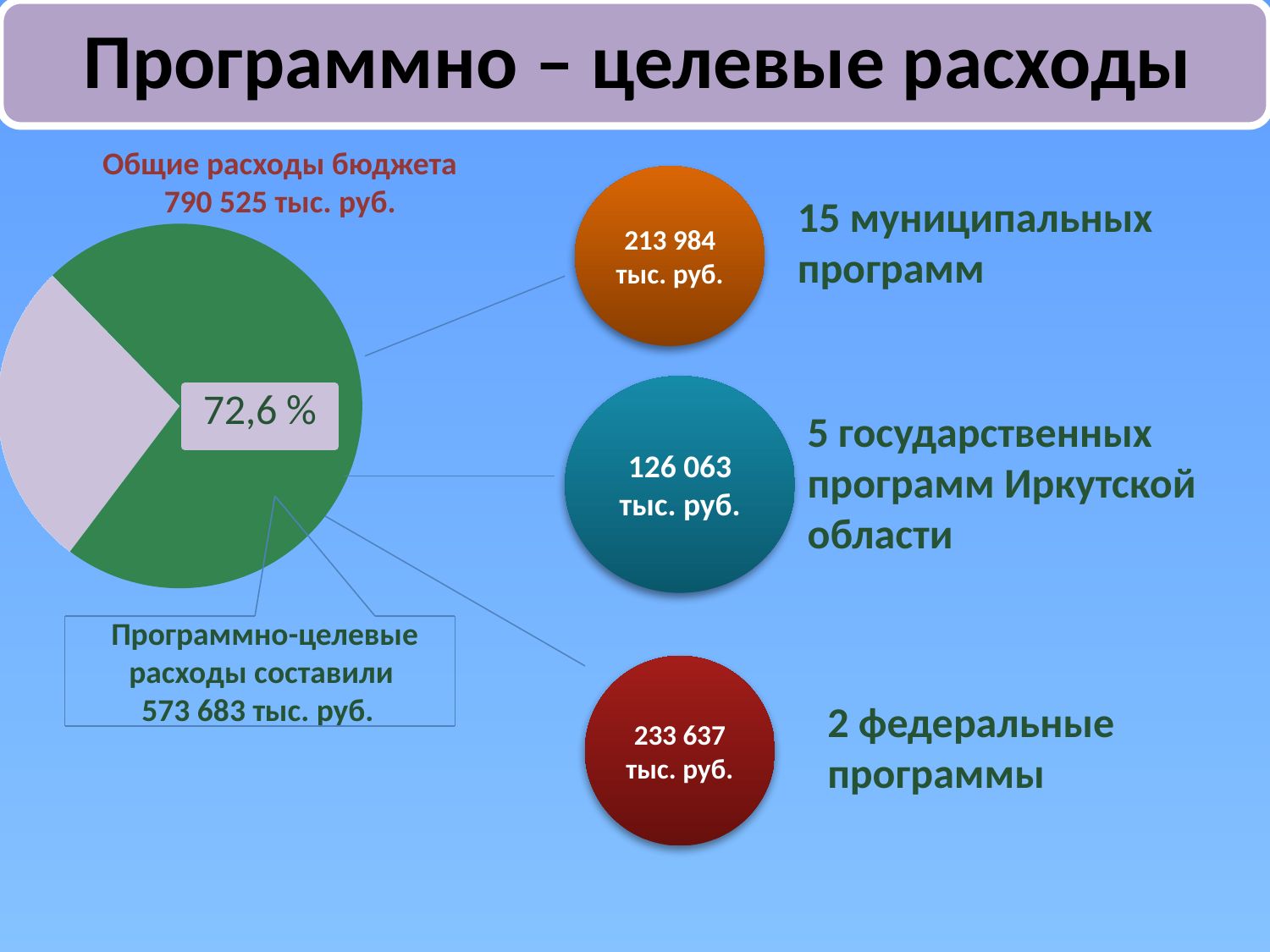
What is the value shown for the 5 state programs of Irkutsk region (государственных программ Иркутской области)? 126 063 тыс. руб. What are the total budget expenses (Общие расходы бюджета) shown above the pie chart? 790 525 тыс. руб. What amount did the program-targeted expenses (Программно-целевые расходы) amount to according to the callout? 573 683 тыс. руб. What kind of chart is shown on the left of the slide? pie chart How many slices does the pie chart have? 2 Which of the three program groups has the smallest amount? 5 государственных программ Иркутской области Which is larger: the amount for municipal programs or the amount for state programs of Irkutsk region? municipal programs (213 984 тыс. руб.) What is the difference between the amount for federal programs and the amount for municipal programs? 19 653 тыс. руб. What is the value shown for the 15 municipal programs (муниципальных программ)? 213 984 тыс. руб. What share of the pie does the green slice (программно-целевые расходы) represent? 72,6 % What is the value shown for the 2 federal programs (федеральные программы)? 233 637 тыс. руб. Which of the three program groups has the largest amount? 2 федеральные программы